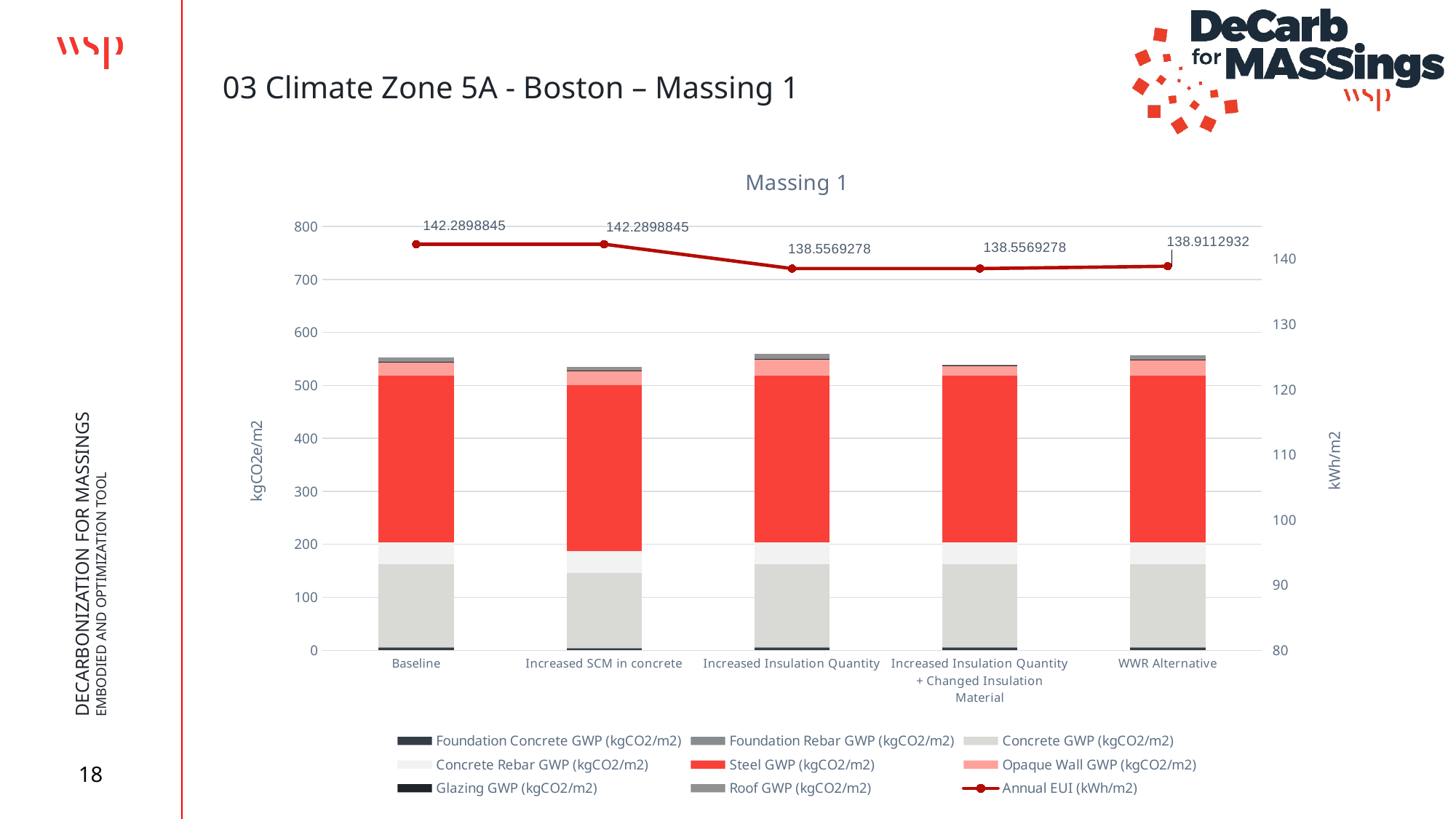
What is the difference between the Annual EUI values for Baseline and WWR Alternative? 3.3785913 How many series does the legend list? 9 Is the total stacked bar value for Increased SCM in concrete greater or less than 600 kgCO2e/m2? less What is the Annual EUI (kWh/m2) value for Increased Insulation Quantity? 138.5569278 How many categories are shown on the x axis? 5 What is the Annual EUI (kWh/m2) value for WWR Alternative? 138.9112932 What kind of chart is shown? Stacked bar chart with a line series What is the difference between the Annual EUI values for Increased SCM in concrete and Increased Insulation Quantity? 3.7329567 What is the label of the right-hand vertical axis? kWh/m2 Does the Annual EUI line rise or fall from Increased SCM in concrete to Increased Insulation Quantity? fall What is the Annual EUI (kWh/m2) value for Baseline? 142.2898845 Which has the larger Annual EUI value, Baseline or WWR Alternative? Baseline